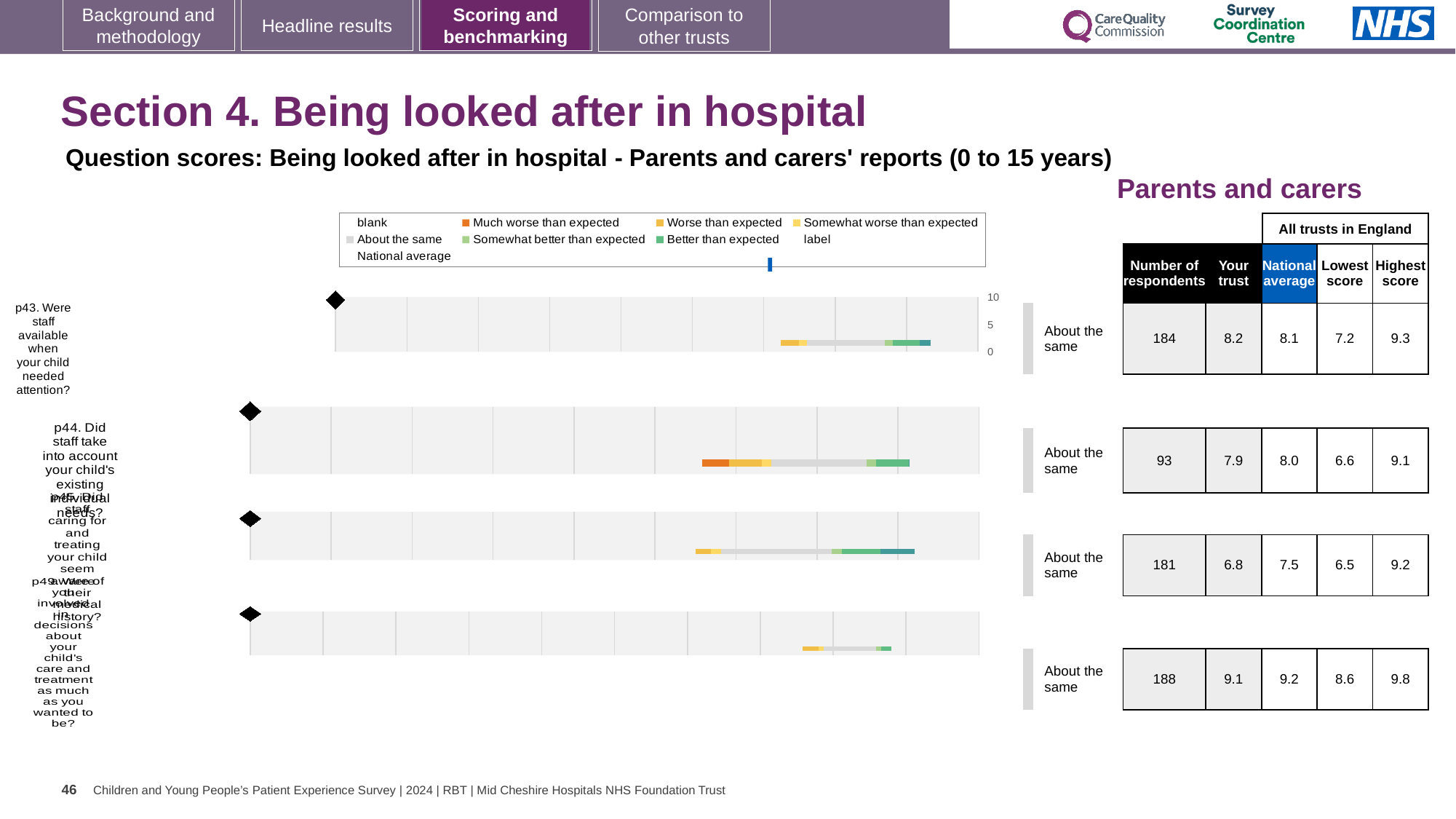
How many respondents are listed for p43 'Were staff available when your child needed attention?' 184 For the third question row (181 respondents), which is larger: the 'Your trust' score or the national average? National average (7.5 vs 6.8) Which question row has the highest 'Your trust' score, and what is it? The fourth row (188 respondents), 9.1 How many question rows (charts) are shown on this slide? 4 In the table next to the charts, what is the 'Your trust' score for p43 'Were staff available when your child needed attention?' 8.2 What type of chart is used to show each question's score? Bar chart For p43, what is the difference between the highest score (9.3) and the lowest score (7.2) across all trusts in England? 2.1 What benchmark category is shown beside every question row on this slide? About the same What is the national average score for p43 'Were staff available when your child needed attention?' 8.1 What is the highest score across all trusts in England for the second question row (93 respondents)? 9.1 Which question row has the lowest 'Your trust' score, and what is it? The third row (181 respondents), 6.8 What is the lowest score across all trusts in England for the fourth question row (188 respondents)? 8.6